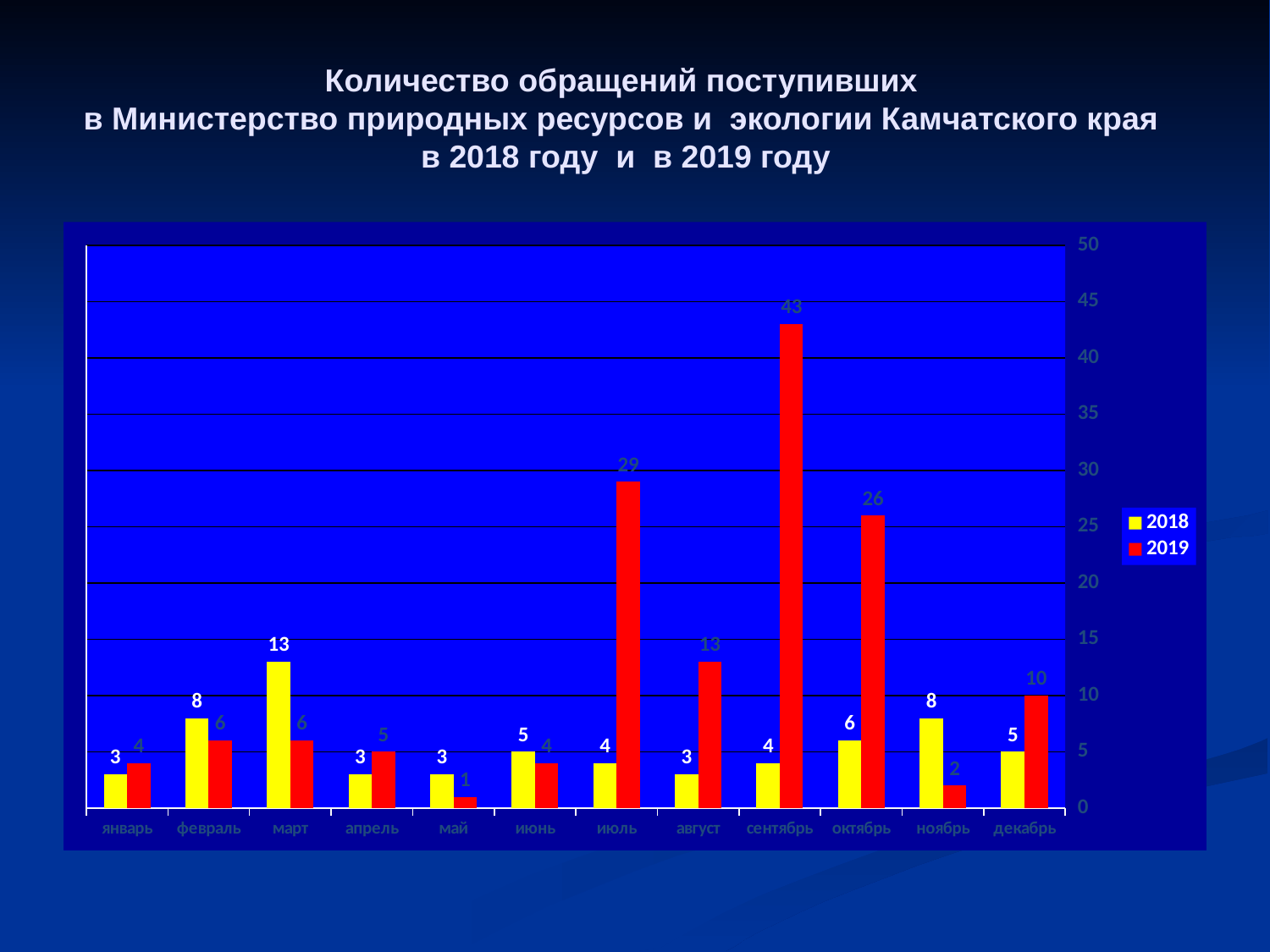
What type of chart is shown on the slide? bar chart Which is larger in ноябрь: the 2018 value or the 2019 value? 2018 Which month has the highest value for the 2019 series? сентябрь What is the difference between the 2019 and 2018 values in июль? 25 What is the value for 2019 in сентябрь? 43 Which month has the lowest value for the 2019 series? май How many series does the legend list? 2 What is the value for 2019 in май? 1 Is the value for 2019 in октябрь greater or less than 20? greater How many months (categories) are shown on the x axis? 12 Which colour represents the 2018 series in the legend? yellow What is the value for 2018 in март? 13